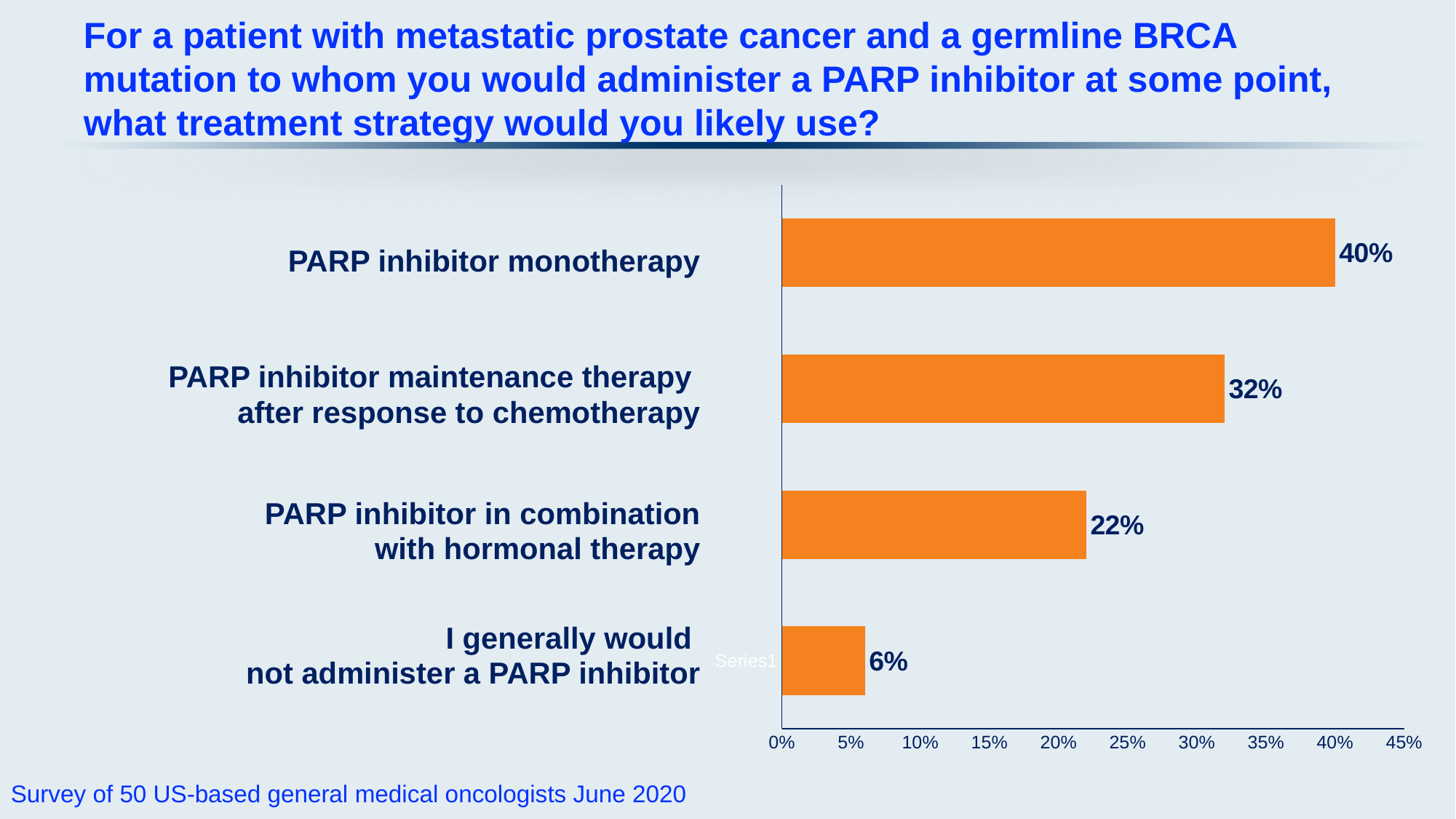
Which treatment strategy has the highest percentage of respondents? PARP inhibitor monotherapy How many response categories are shown in the chart? 4 What percentage of respondents chose PARP inhibitor monotherapy? 40% Which has a larger share of respondents: PARP inhibitor in combination with hormonal therapy or PARP inhibitor maintenance therapy after response to chemotherapy? PARP inhibitor maintenance therapy after response to chemotherapy What is the difference in percentage points between PARP inhibitor monotherapy and PARP inhibitor maintenance therapy after response to chemotherapy? 8 percentage points Which response option has the lowest percentage? I generally would not administer a PARP inhibitor What percentage of respondents chose PARP inhibitor in combination with hormonal therapy? 22% What type of chart is shown on the slide? Bar chart What is the maximum value shown on the horizontal axis of the chart? 45% Is the value for PARP inhibitor in combination with hormonal therapy greater or less than 25%? less What percentage of respondents chose PARP inhibitor maintenance therapy after response to chemotherapy? 32% What percentage of respondents said they generally would not administer a PARP inhibitor? 6%